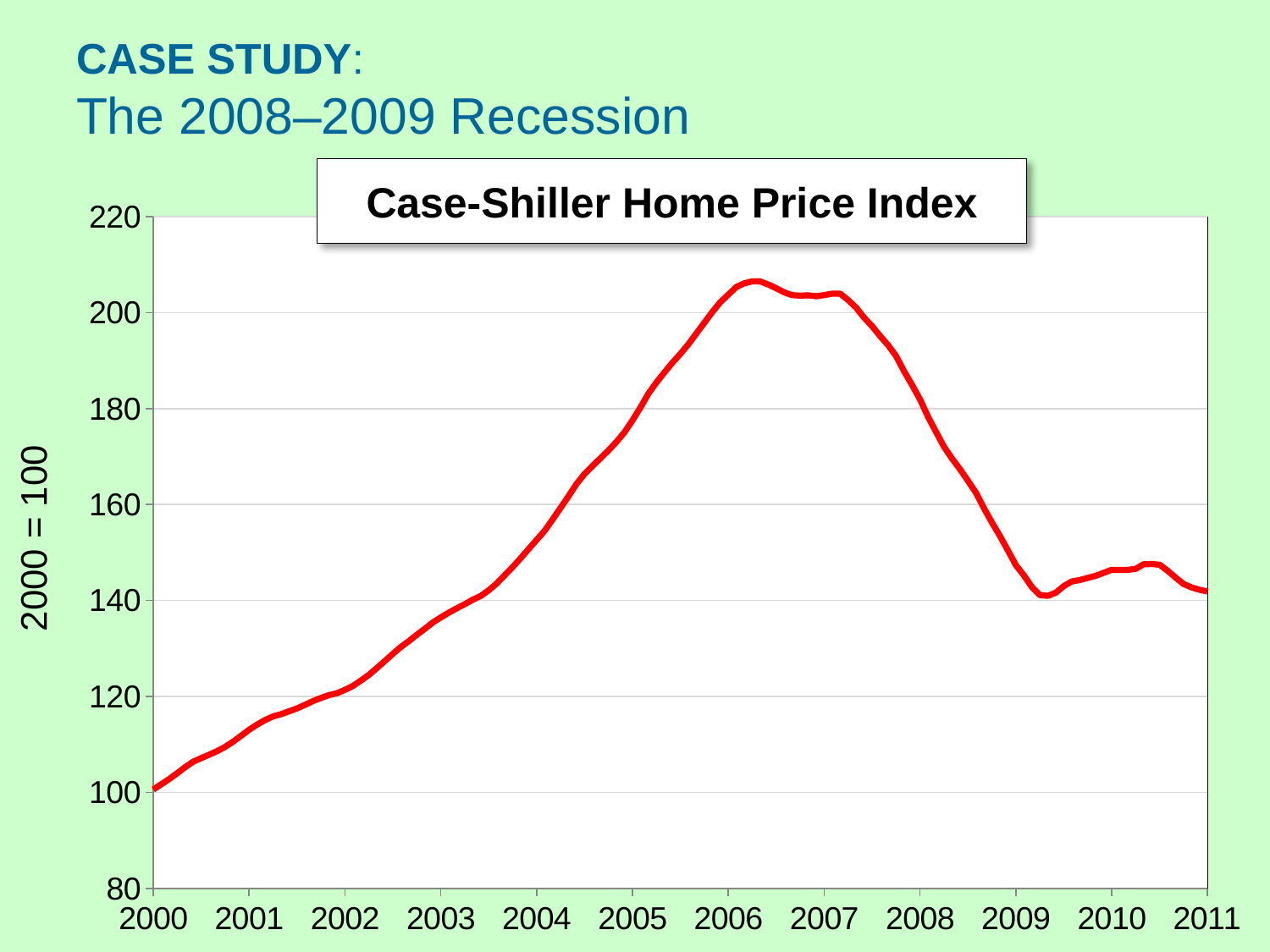
What is the title of the chart? Case-Shiller Home Price Index Which year has the higher index value, 2005 or 2010? 2005 Does the Case-Shiller Home Price Index rise or fall between 2007 and 2009? fall What is the value of the Case-Shiller Home Price Index in 2000? 100 Is the value of the index in 2001 greater or less than 120? less Is the value of the index in 2004 greater or less than 140? greater Is the value of the index in 2011 greater or less than 160? less What kind of chart is shown on the slide? line chart In which year shown on the x axis does the Case-Shiller Home Price Index reach its highest value? 2006 What is the label on the vertical axis of the chart? 2000 = 100 In which year shown on the x axis is the Case-Shiller Home Price Index at its lowest value? 2000